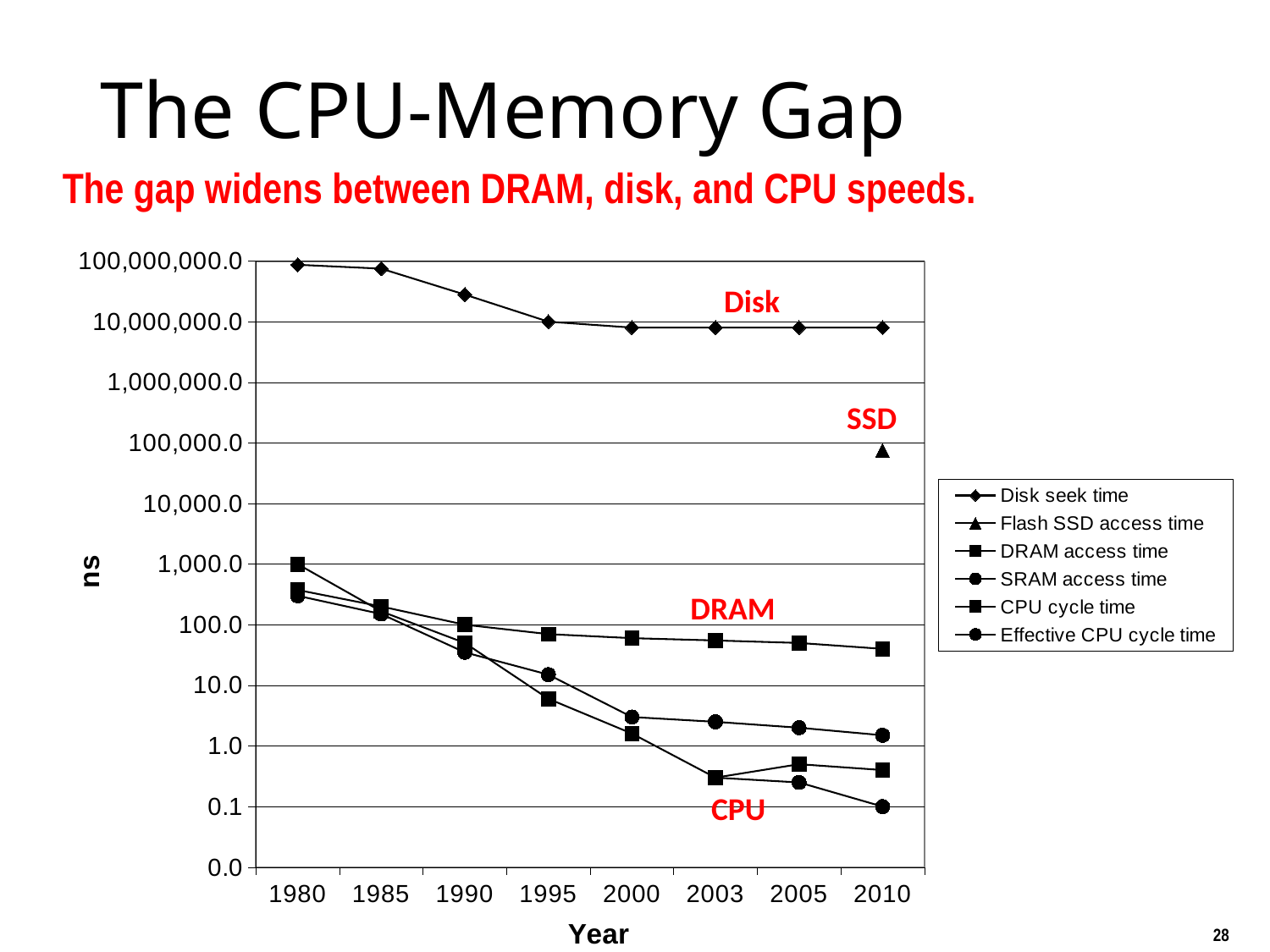
Which series has the highest value in 2010? Disk seek time Does the Disk seek time rise or fall from 1980 to 2010? fall What kind of chart is shown on the slide? line chart How many years are marked along the x axis? 8 How many series does the legend list? 6 Is the SRAM access time value for 2000 greater or less than 1.0? greater What is the label on the y axis? ns Which series has the lowest value in 2010? Effective CPU cycle time Is the Disk seek time value for 1980 greater or less than 10,000,000.0? greater Is the DRAM access time value for 2010 greater or less than 100.0? less In 2010, which is larger: Disk seek time or DRAM access time? Disk seek time